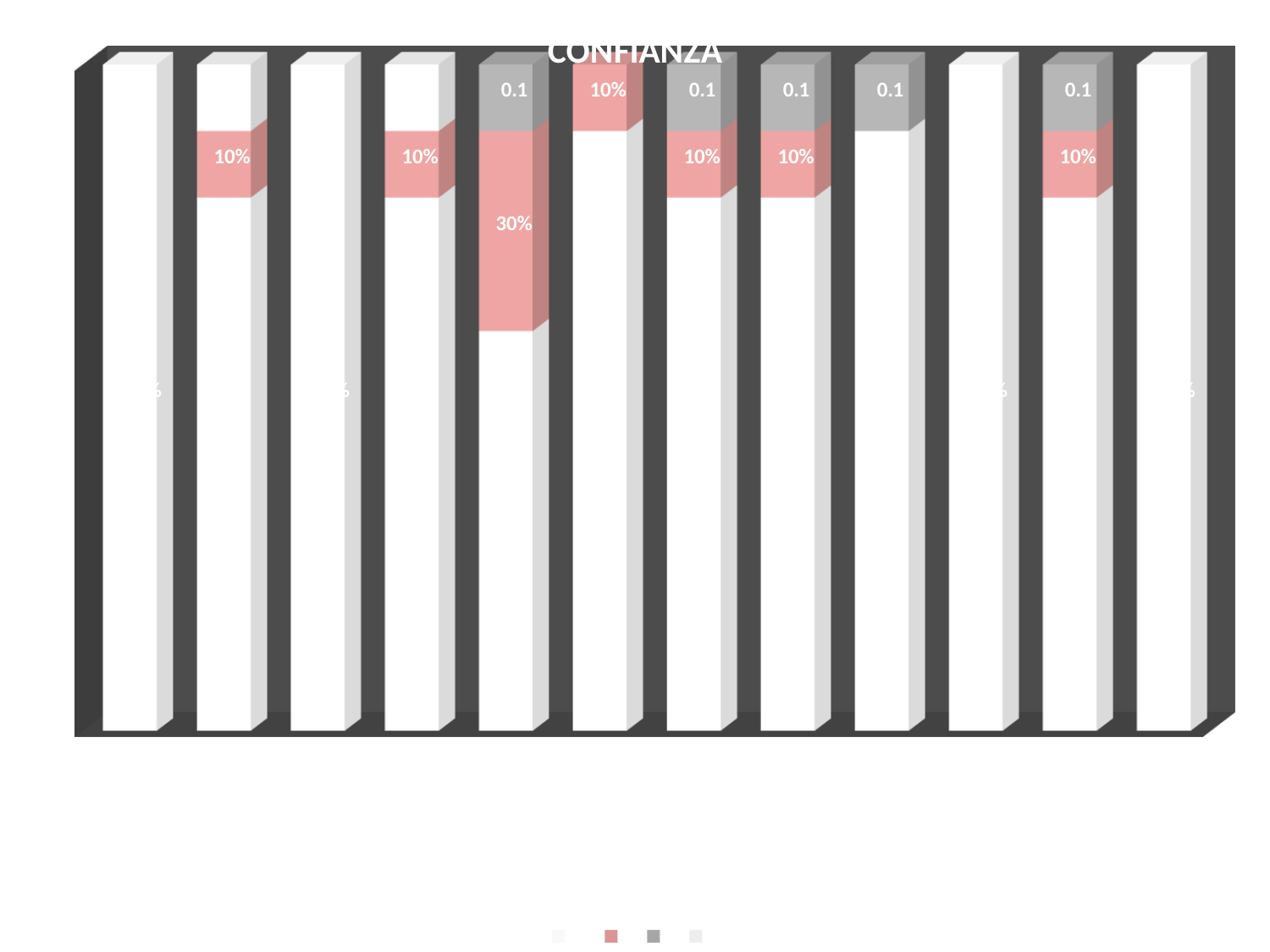
How many bars have a grey segment labelled 0.1? 5 What is the value of the grey segment in the fifth bar from the left? 0.1 What is the title of the chart? CONFIANZA What is the value of the pink segment in the second bar from the left? 10% What colour is the segment labelled 30%? pink What kind of chart is shown on the slide? bar chart Is the pink segment larger in the fifth bar from the left or in the second bar from the left? the fifth bar from the left Which bar has the largest pink segment? the fifth bar from the left How many series does the legend list? 4 What is the difference between the pink segment of the fifth bar from the left (30%) and the pink segment of the second bar from the left (10%)? 20% What is the value of the pink segment in the fifth bar from the left? 30% How many bars are plotted in the chart? 12